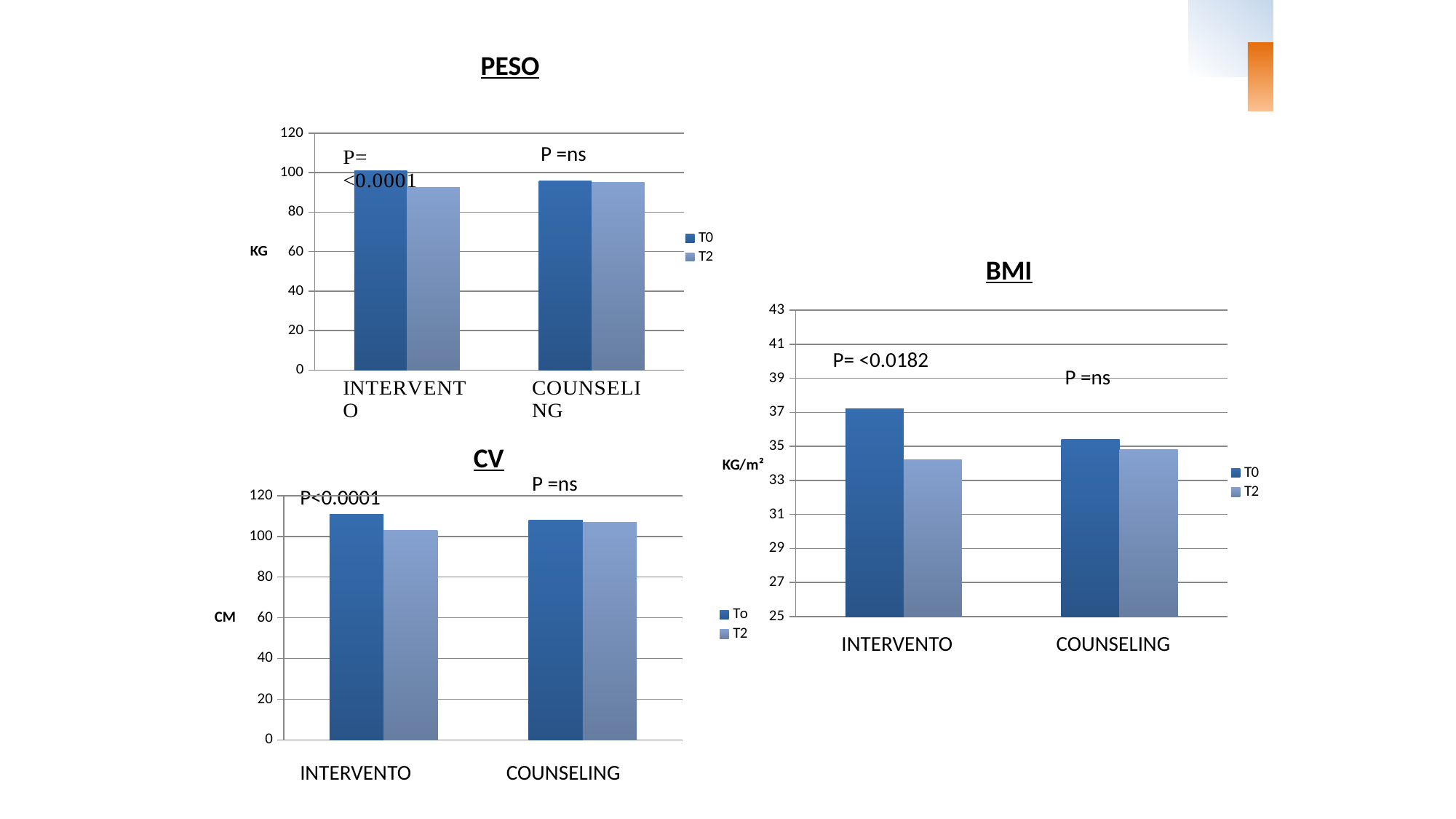
In the BMI chart, is the T2 value for INTERVENTO greater or less than 35? less In the PESO chart, what kind of chart is shown? bar chart In the CV chart, which is larger for INTERVENTO, T0 or T2? T0 In the BMI chart, what unit label is shown on the vertical axis? KG/m² In the PESO chart, which is larger for INTERVENTO, T0 or T2? T0 In the CV chart, what unit label is shown on the vertical axis? CM In the PESO chart, how many series does the legend list? 2 In the CV chart, is the T0 value for INTERVENTO greater or less than 100? greater In the PESO chart, how many categories are shown on the x axis? 2 In the PESO chart, is the T2 value for INTERVENTO greater or less than 100? less